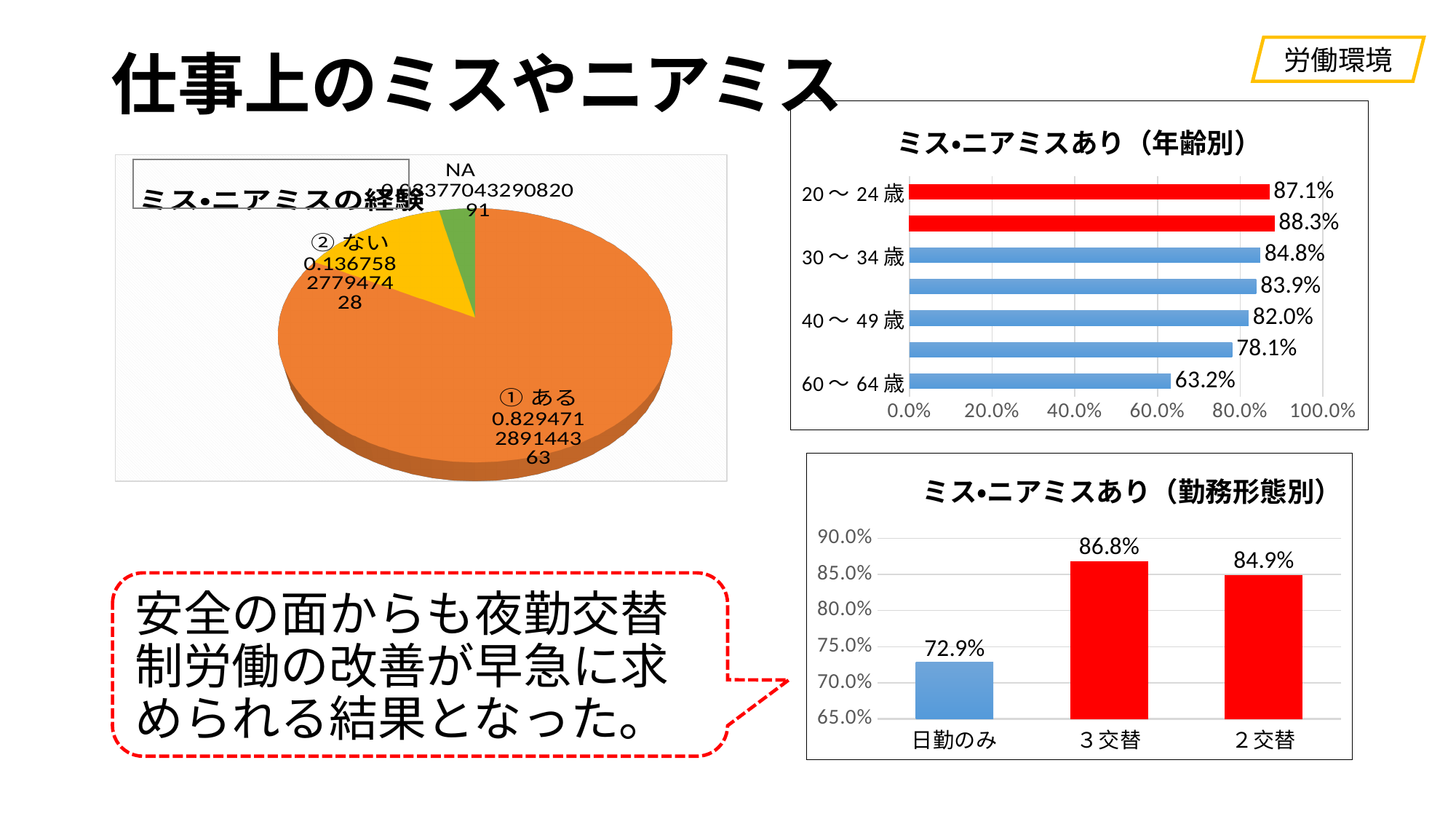
In the chart titled ミス・ニアミスあり（年齢別）, how many bars are plotted? 7 In the pie chart titled ミス・ニアミスの経験, which slice is the largest? ① ある In the chart titled ミス・ニアミスあり（年齢別）, what is the value for 20～24歳? 87.1% In the chart titled ミス・ニアミスあり（勤務形態別）, what is the difference between the values for ３交替 and 日勤のみ? 13.9 percentage points In the chart titled ミス・ニアミスあり（勤務形態別）, what is the value for 日勤のみ? 72.9% In the chart titled ミス・ニアミスあり（年齢別）, what is the value for 60～64歳? 63.2% In the chart titled ミス・ニアミスあり（勤務形態別）, which category has the highest value? ３交替 In the chart titled ミス・ニアミスあり（年齢別）, what is the difference between the values for 20～24歳 and 60～64歳? 23.9 percentage points What kind of chart is the chart titled ミス・ニアミスの経験 on the left of the slide? Pie chart In the chart titled ミス・ニアミスあり（年齢別）, which labelled age group has the lowest value? 60～64歳 In the chart titled ミス・ニアミスあり（勤務形態別）, what is the value for ３交替? 86.8% In the chart titled ミス・ニアミスあり（勤務形態別）, which is larger, the value for ２交替 or the value for 日勤のみ? ２交替